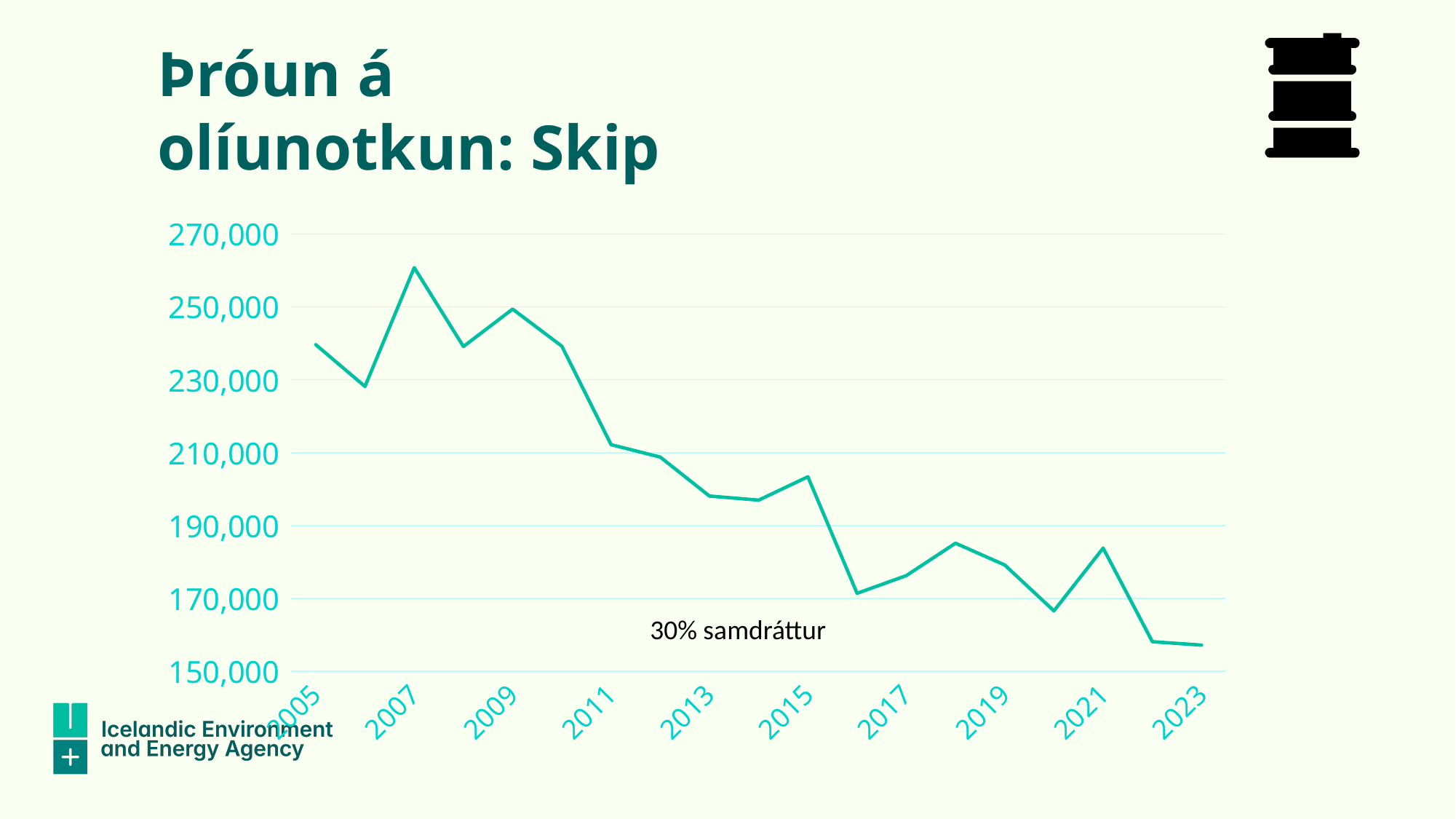
Is the value for 2023 greater or less than 170,000? less How many year labels are shown on the x axis? 10 Overall, do the values rise or fall from 2005 to 2023? fall Is the value for 2013 greater or less than 210,000? less What kind of chart is shown on the slide? line chart What annotation text is printed inside the chart area? 30% samdráttur In which year does the line reach its highest value? 2007 Which year has the larger value, 2011 or 2021? 2011 Is the value for 2007 greater or less than 250,000? greater What is the title of the chart on the slide? Þróun á olíunotkun: Skip Which year has the larger value, 2007 or 2005? 2007